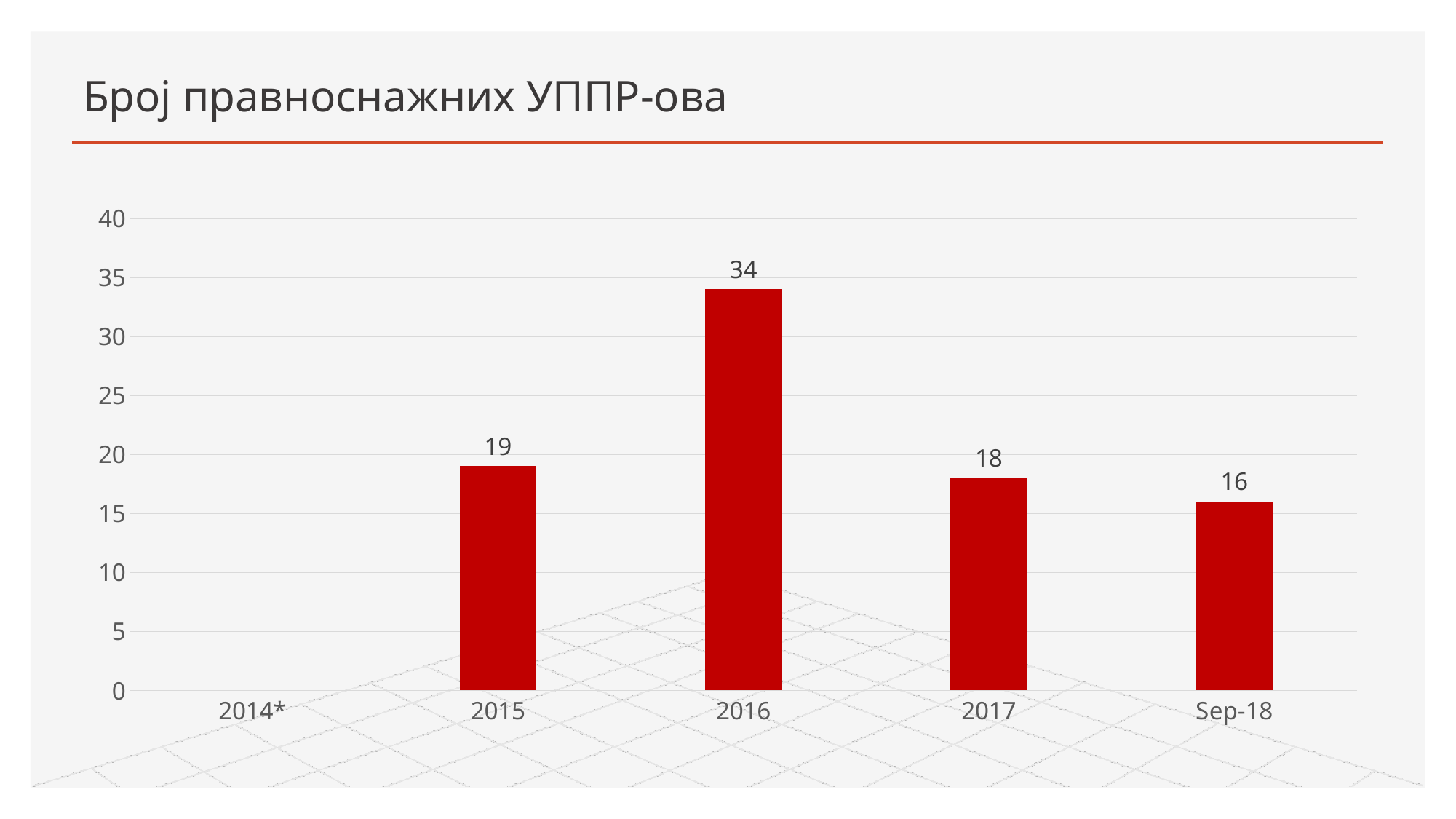
What is the title of the chart? Број правноснажних УППР-ова What is the difference between the values for 2016 and 2015? 15 What kind of chart is shown on the slide? bar chart What is the value for 2016? 34 Which category has the highest value? 2016 Which category with a visible bar has the lowest value? Sep-18 Is the value for 2016 greater or less than 30? greater What is the value for 2017? 18 How many categories are shown on the x axis? 5 Which is larger, the value for 2015 or the value for 2017? 2015 What is the value for Sep-18? 16 What is the value for 2015? 19